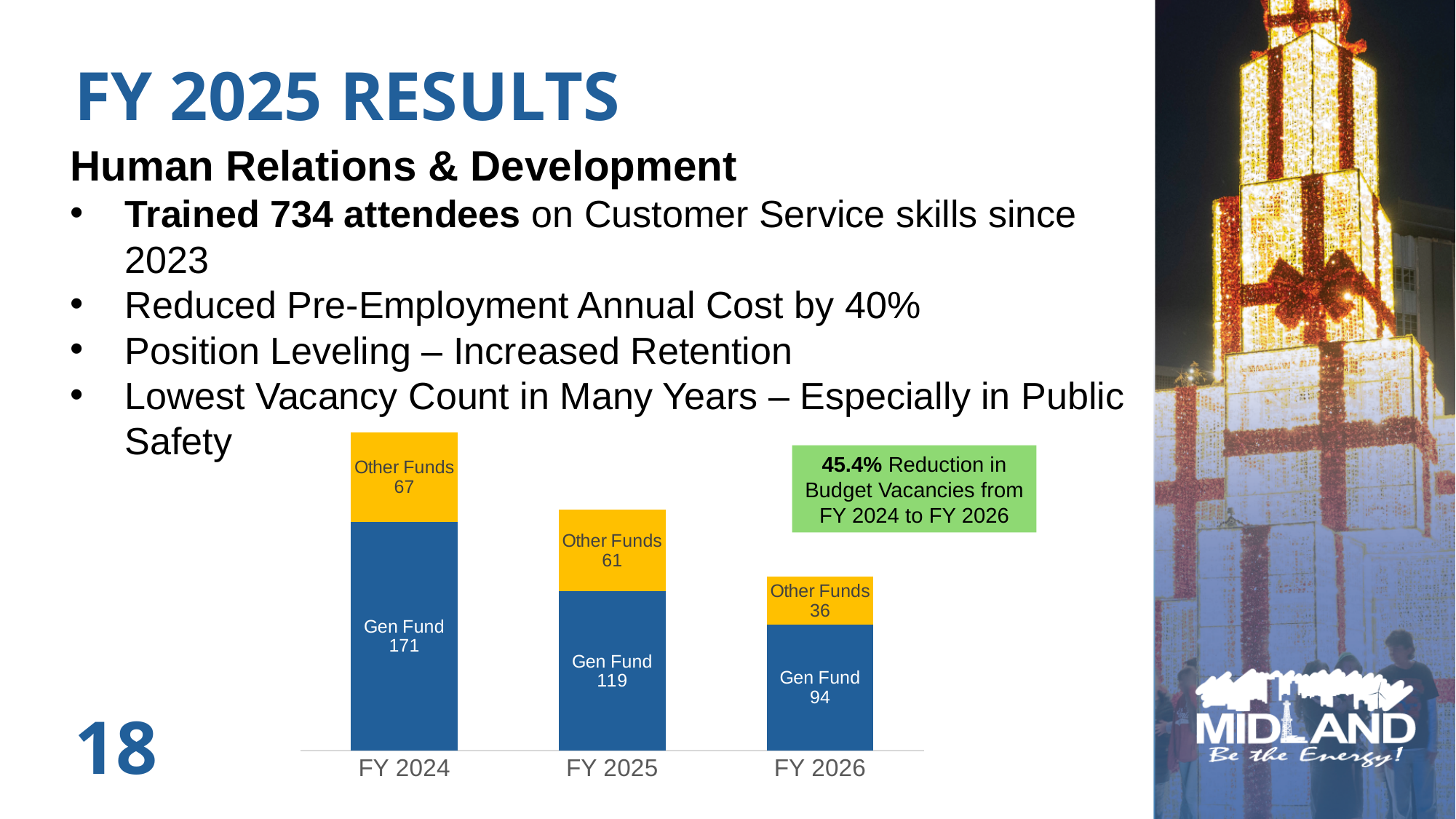
What is the difference between the Gen Fund values for FY 2024 and FY 2025? 52 What kind of chart is shown on the slide? Stacked bar chart What is the Other Funds value for FY 2026? 36 Is the Other Funds value larger in FY 2024 or FY 2025? FY 2024 Which fiscal year has the highest Gen Fund value? FY 2024 What is the Gen Fund value for FY 2026? 94 What is the total of the stacked bar for FY 2026? 130 How many fiscal years are shown on the x axis of the chart? 3 What is the total of the stacked bar for FY 2024? 238 Which fiscal year has the lowest Other Funds value? FY 2026 What is the Gen Fund value for FY 2024? 171 What is the Other Funds value for FY 2025? 61